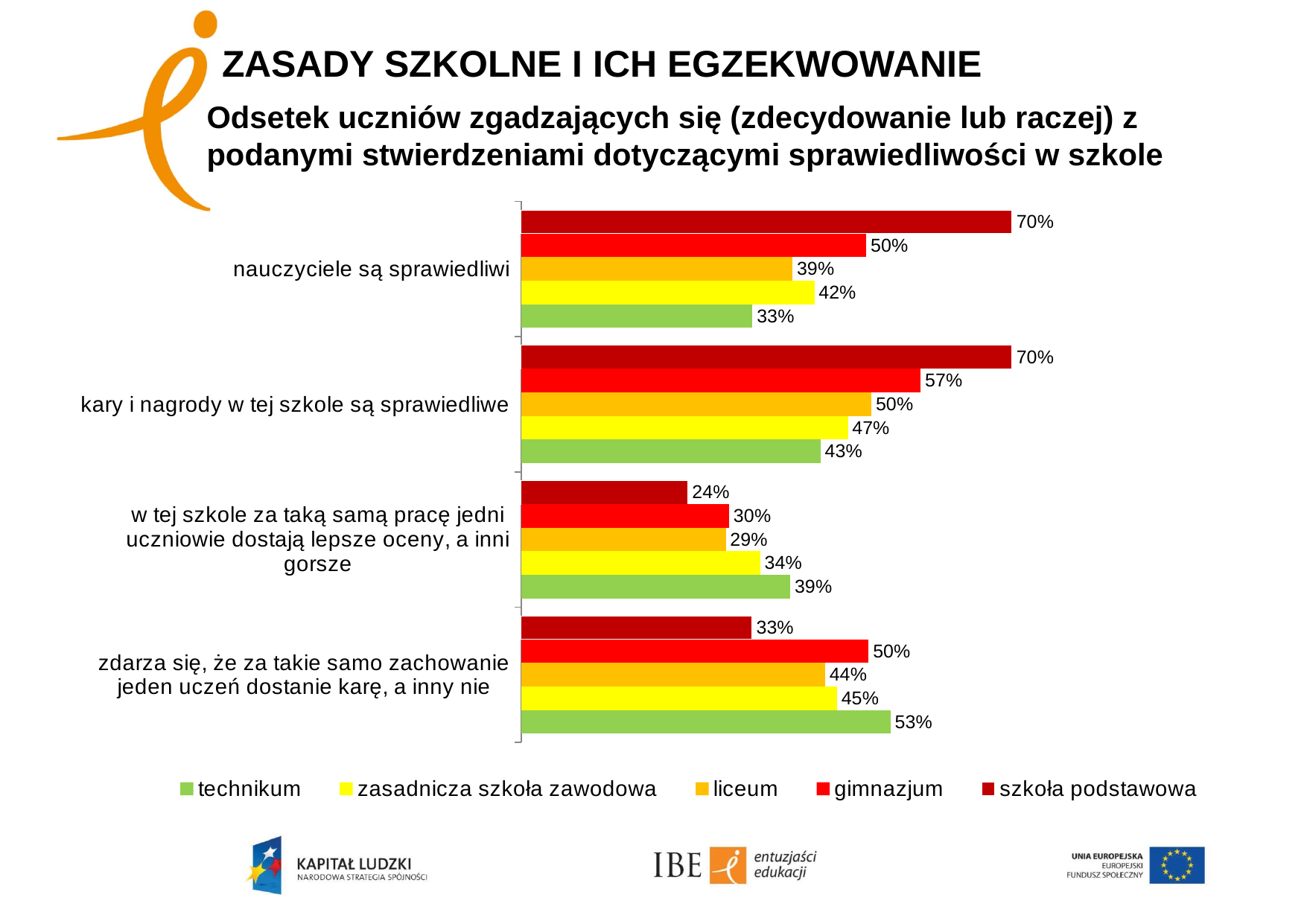
How many statements (categories) are shown on the chart? 4 What is the value for technikum for the statement "kary i nagrody w tej szkole są sprawiedliwe"? 43% What percentage of szkoła podstawowa students agree that "nauczyciele są sprawiedliwi"? 70% What is the value for gimnazjum for the statement "zdarza się, że za takie samo zachowanie jeden uczeń dostanie karę, a inny nie"? 50% What kind of chart is shown on the slide? bar chart How many series does the legend list? 5 What is the value for liceum for "w tej szkole za taką samą pracę jedni uczniowie dostają lepsze oceny, a inni gorsze"? 29% Which school type has the highest value for "zdarza się, że za takie samo zachowanie jeden uczeń dostanie karę, a inny nie"? technikum For "kary i nagrody w tej szkole są sprawiedliwe", which is larger: the value for liceum or for zasadnicza szkoła zawodowa? liceum What is the difference between szkoła podstawowa and technikum for "nauczyciele są sprawiedliwi"? 37 percentage points Which school type has the lowest value for "w tej szkole za taką samą pracę jedni uczniowie dostają lepsze oceny, a inni gorsze"? szkoła podstawowa Which colour represents technikum in the legend? green